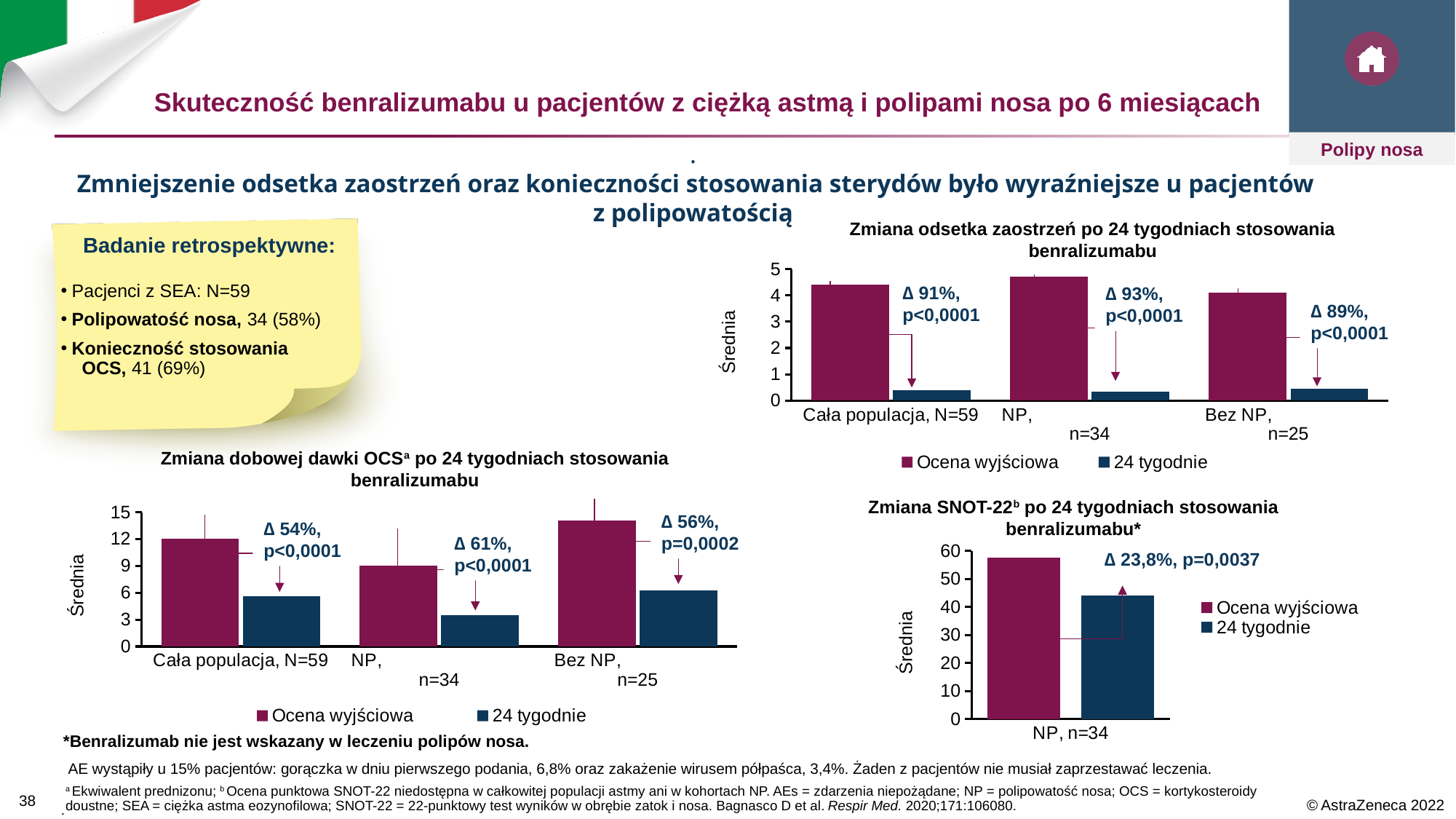
In the chart 'Zmiana dobowej dawki OCS po 24 tygodniach stosowania benralizumabu', how many series does the legend list? 2 In the chart 'Zmiana SNOT-22 po 24 tygodniach stosowania benralizumabu*', what percentage change (Δ) is printed above the bars? 23,8% In the chart 'Zmiana SNOT-22 po 24 tygodniach stosowania benralizumabu*', is the '24 tygodnie' value greater or less than 40? greater In the chart 'Zmiana dobowej dawki OCS po 24 tygodniach stosowania benralizumabu', which category has the lowest 'Ocena wyjściowa' value? NP, n=34 In the chart 'Zmiana dobowej dawki OCS po 24 tygodniach stosowania benralizumabu', which has the larger 'Ocena wyjściowa' value: 'Cała populacja, N=59' or 'NP, n=34'? Cała populacja, N=59 In the chart 'Zmiana odsetka zaostrzeń po 24 tygodniach stosowania benralizumabu', what percentage change (Δ) is printed for 'NP, n=34'? 93% In the chart 'Zmiana odsetka zaostrzeń po 24 tygodniach stosowania benralizumabu', how many categories are shown on the x axis? 3 In the chart 'Zmiana dobowej dawki OCS po 24 tygodniach stosowania benralizumabu', which category has the highest 'Ocena wyjściowa' value? Bez NP, n=25 In the chart 'Zmiana odsetka zaostrzeń po 24 tygodniach stosowania benralizumabu', is the '24 tygodnie' value for 'NP, n=34' greater or less than 1? less In the chart 'Zmiana dobowej dawki OCS po 24 tygodniach stosowania benralizumabu', is the 'Ocena wyjściowa' value for 'Bez NP, n=25' greater or less than 12? greater What kind of chart is 'Zmiana dobowej dawki OCS po 24 tygodniach stosowania benralizumabu'? bar chart